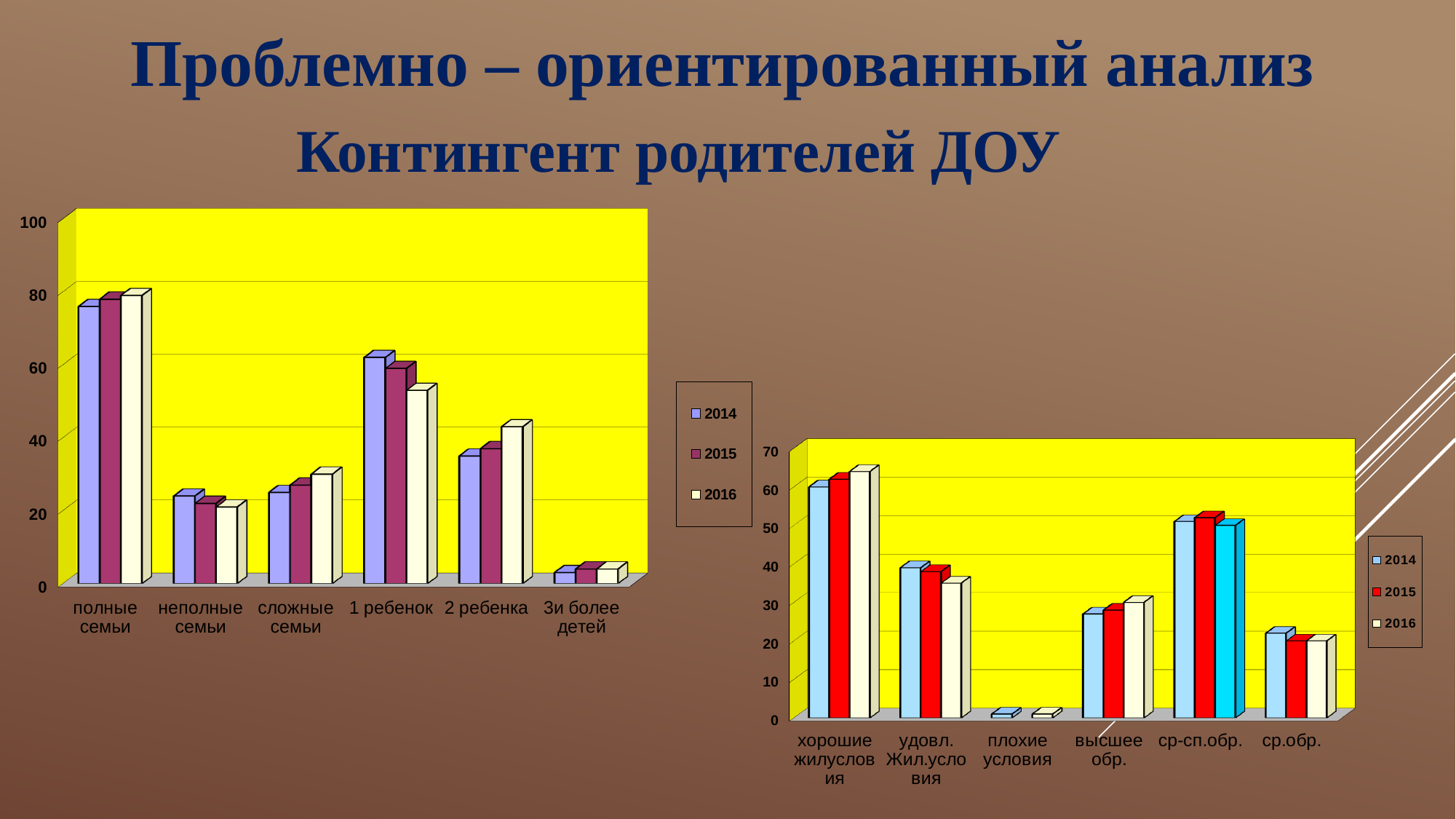
What kind of chart is the left chart on the slide? bar chart In the right chart, is the 2014 value for ср.обр. greater or less than 30? less In the left chart, is the 2014 value for полные семьи greater or less than 60? greater In the left chart, do the values for 1 ребенок rise or fall from 2014 to 2016? fall In the right chart, which category has the lowest bars? плохие условия How many series does the legend of the left chart list? 3 In the right chart, which category has the highest bars? хорошие жилусловия In the left chart, which category has the highest bars? полные семьи In the left chart, which category has the lowest bars? 3и более детей In the left chart, which is larger for 2014: 1 ребенок or 2 ребенка? 1 ребенок In the left chart, is the 2016 value for 1 ребенок greater or less than 60? less How many categories are shown on the x axis of the left chart? 6